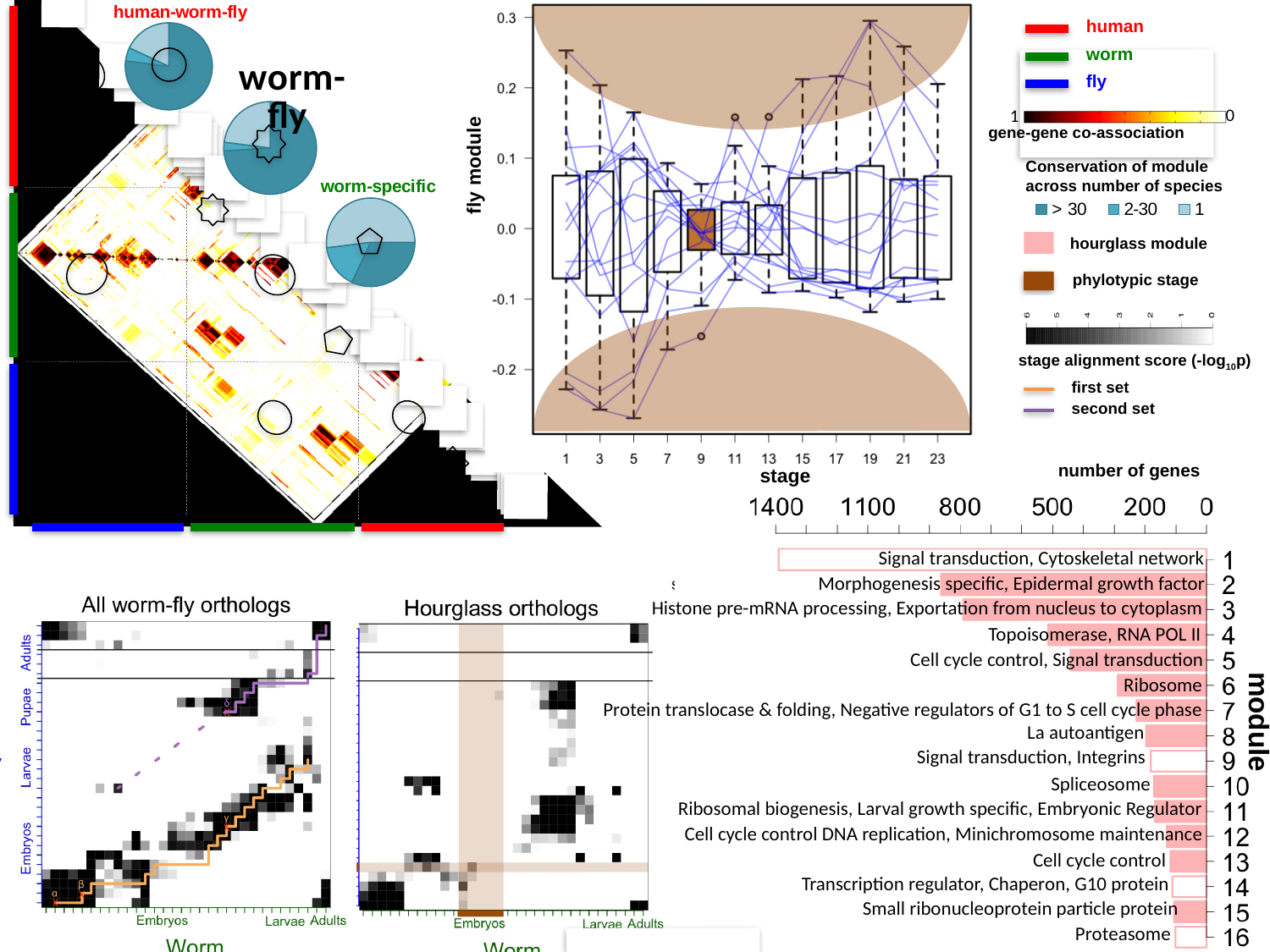
How many stages are labeled on the x axis of the box plot of fly module versus stage? 12 In the 'number of genes' bar chart, is the value for module 1 (Signal transduction, Cytoskeletal network) greater or less than 1100? greater How many modules are listed in the 'number of genes' bar chart? 16 In the 'number of genes' bar chart, which module has the most genes? Module 1 (Signal transduction, Cytoskeletal network) In the 'number of genes' bar chart, which has more genes: module 4 (Topoisomerase, RNA POL II) or module 8 (La autoantigen)? Module 4 (Topoisomerase, RNA POL II) In the box plot of fly module versus stage, which stage is highlighted as the phylotypic stage? 9 Which three species are listed in the colour legend at the top right of the slide? human, worm, fly What kind of chart is the 'number of genes' chart on the right of the slide? bar chart In the 'number of genes' bar chart, is the value for module 16 (Proteasome) greater or less than 200? less In the 'number of genes' bar chart, is the value for module 6 (Ribosome) greater or less than 500? less What is the y-axis label of the box plot at the top centre of the slide? fly module In the 'number of genes' bar chart, which has more genes: module 2 (Morphogenesis specific, Epidermal growth factor) or module 6 (Ribosome)? Module 2 (Morphogenesis specific, Epidermal growth factor)